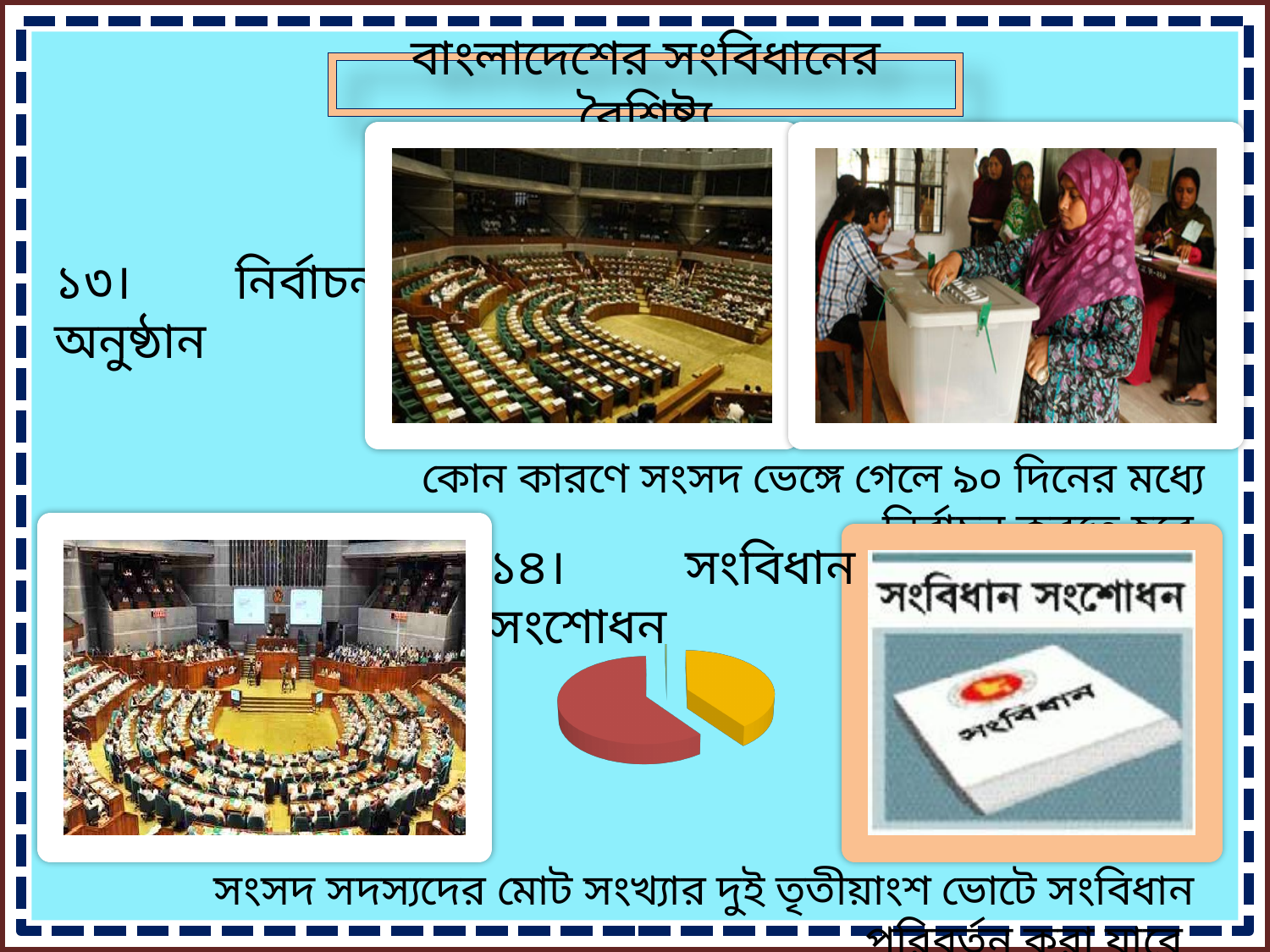
Which slice of the pie chart is the largest? the red slice What colours are the two slices of the pie chart? red and yellow Which slice of the pie chart is larger, the red one or the yellow one? the red one What kind of chart is shown on the slide? pie chart Does the pie chart have a legend? No Which slice of the pie chart is the smallest? the yellow slice How many slices does the pie chart have? 2